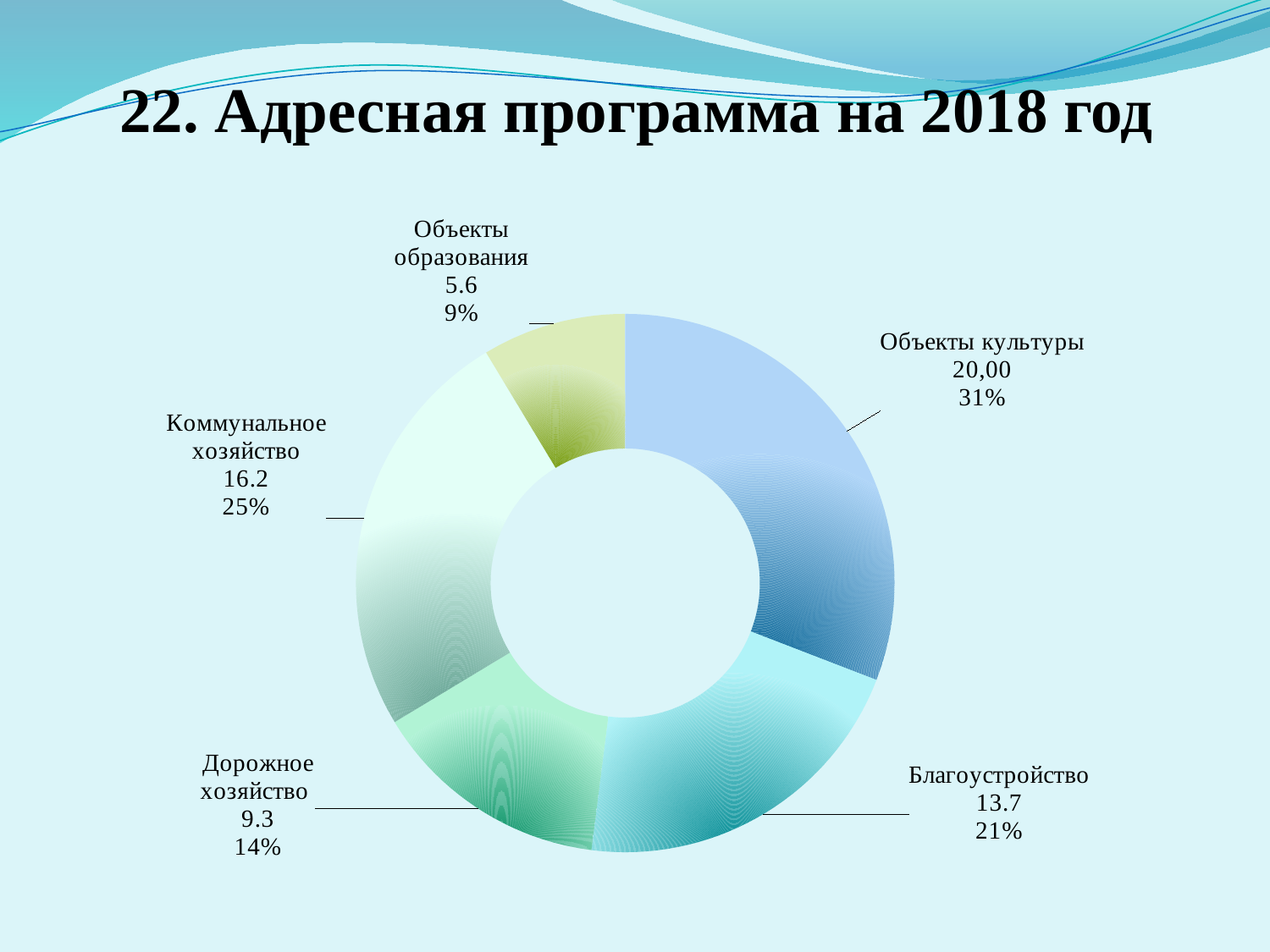
What percentage share does Благоустройство have? 21% What percentage share does Коммунальное хозяйство have? 25% What is the difference between the values for Коммунальное хозяйство and Дорожное хозяйство? 6.9 Which category has the largest share of the chart? Объекты культуры What is the value for Объекты образования? 5.6 What is the value for Объекты культуры? 20,00 Which category has the smallest share of the chart? Объекты образования What is the value for Дорожное хозяйство? 9.3 How many categories are shown in the chart? 5 What kind of chart is shown on the slide? Doughnut (pie) chart What is the value for Благоустройство? 13.7 What is the value for Коммунальное хозяйство? 16.2